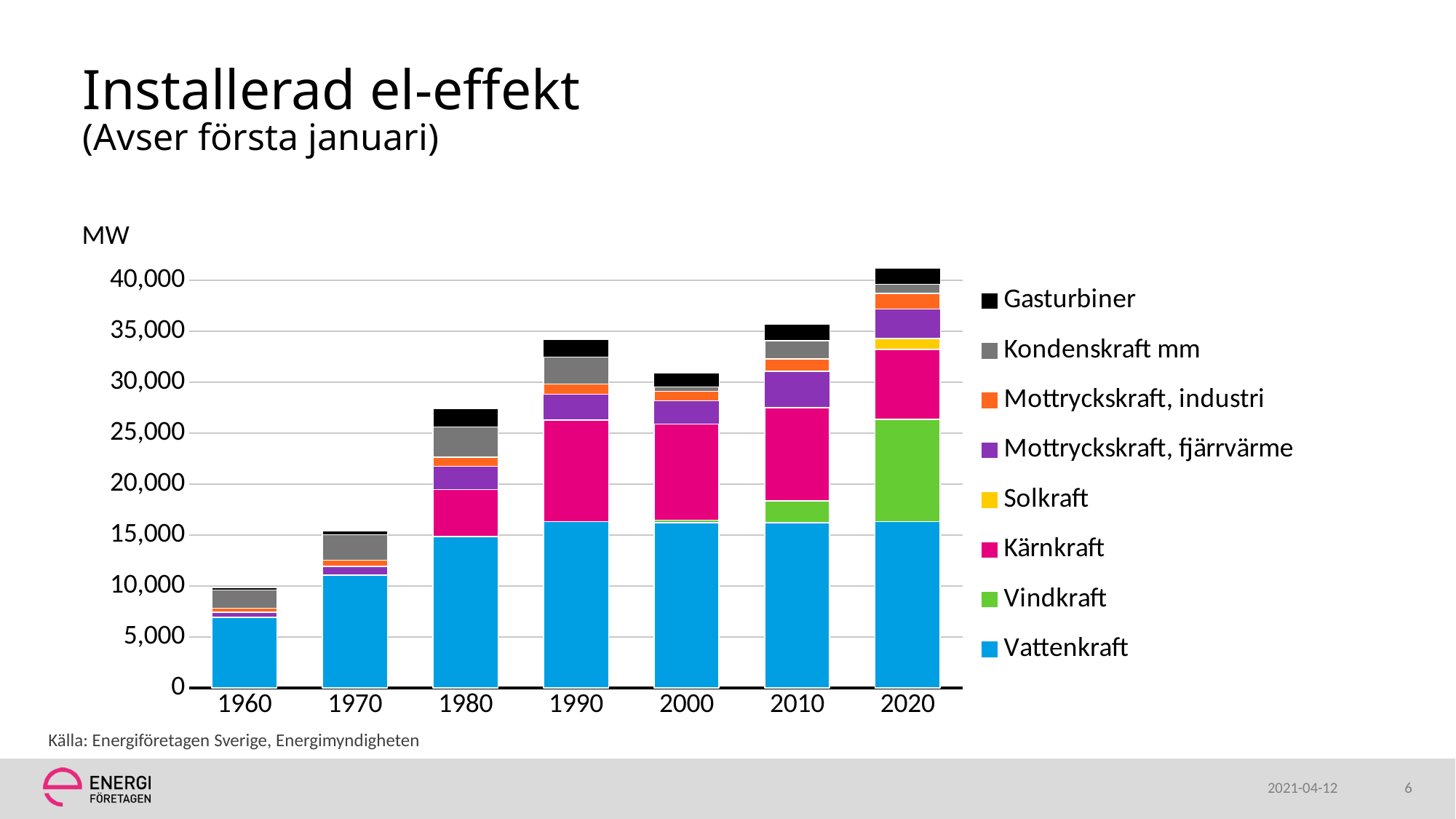
What unit is shown on the y axis of the chart? MW Which year has the larger total installed capacity, 1990 or 2000? 1990 Is the total bar for 1980 greater or less than 25,000 MW? greater Which year has the highest total installed capacity in the chart? 2020 How many years are shown on the x axis of the chart? 7 What kind of chart is shown on the slide? stacked bar chart Which series is shown in green in the chart's legend? Vindkraft Is the total bar for 2020 greater or less than 40,000 MW? greater How many series does the chart's legend list? 8 Is the Vattenkraft segment for 2020 greater or less than 15,000 MW? greater Which year has the lowest total installed capacity in the chart? 1960